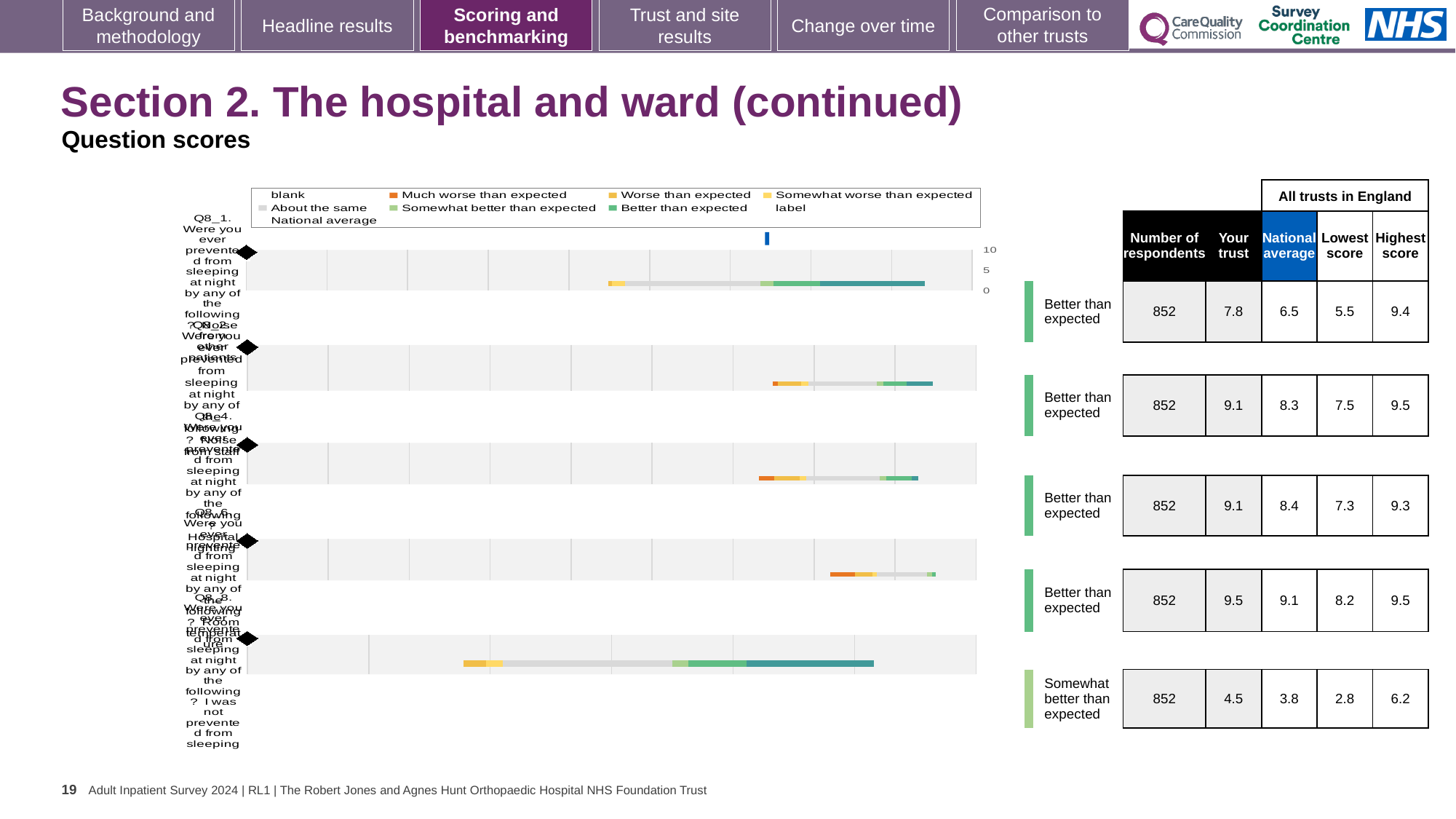
In the fourth row, which is larger: the 'Your trust' score or the national average? Your trust (9.5) What kind of chart is shown on the slide? bar chart What is the national average for the top row (Q8_1) in the table beside the chart? 6.5 How many question rows (bars) does the chart show? 5 What benchmark label is given to the bottom row of the chart? Somewhat better than expected What is the 'Your trust' score for the bottom row of the chart? 4.5 What is the difference between 'Your trust' and the national average for the top row (Q8_1)? 1.3 What is the highest score among all trusts in England for the top row (Q8_1)? 9.4 What is the 'Your trust' score for the top row (Q8_1) in the table beside the chart? 7.8 Which row has the lowest 'Your trust' score? the bottom row (4.5) Which row has the highest 'Your trust' score? the fourth row (9.5) How many respondents are listed for each question row? 852